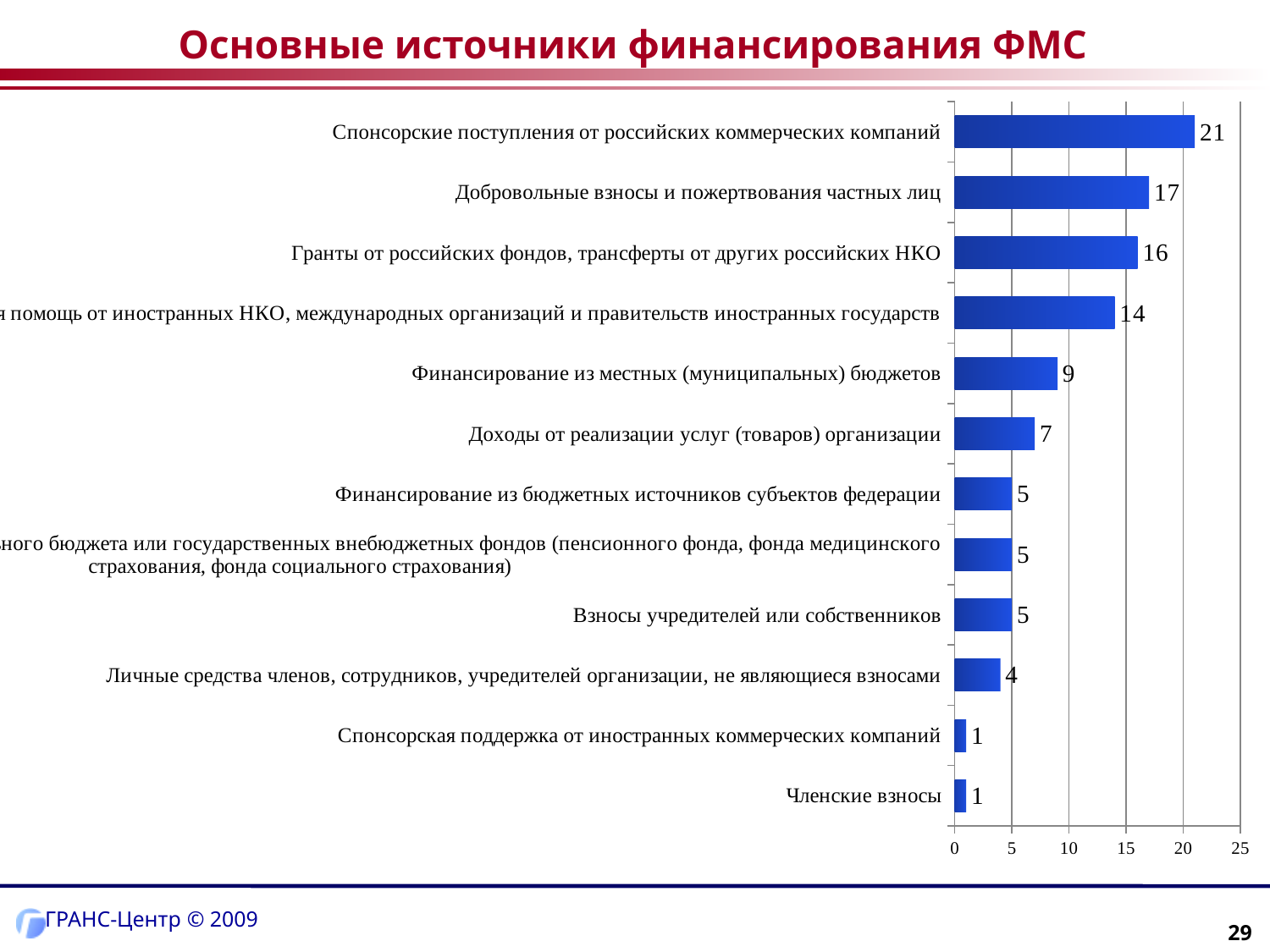
What is the value for "Спонсорские поступления от российских коммерческих компаний"? 21 What is the value for "Членские взносы"? 1 What is the value for "Добровольные взносы и пожертвования частных лиц"? 17 How many categories are plotted in the chart? 12 Is the value for "Гранты от российских фондов, трансферты от других российских НКО" greater or less than 10? greater What is the value for "Финансирование из местных (муниципальных) бюджетов"? 9 What is the maximum value shown on the horizontal axis? 25 What is the difference between the values for "Спонсорские поступления от российских коммерческих компаний" and "Добровольные взносы и пожертвования частных лиц"? 4 What is the title of the slide? Основные источники финансирования ФМС What type of chart is shown on the slide? Bar chart Which category has the highest value? Спонсорские поступления от российских коммерческих компаний Which is larger: the value for "Доходы от реализации услуг (товаров) организации" or the value for "Взносы учредителей или собственников"? Доходы от реализации услуг (товаров) организации